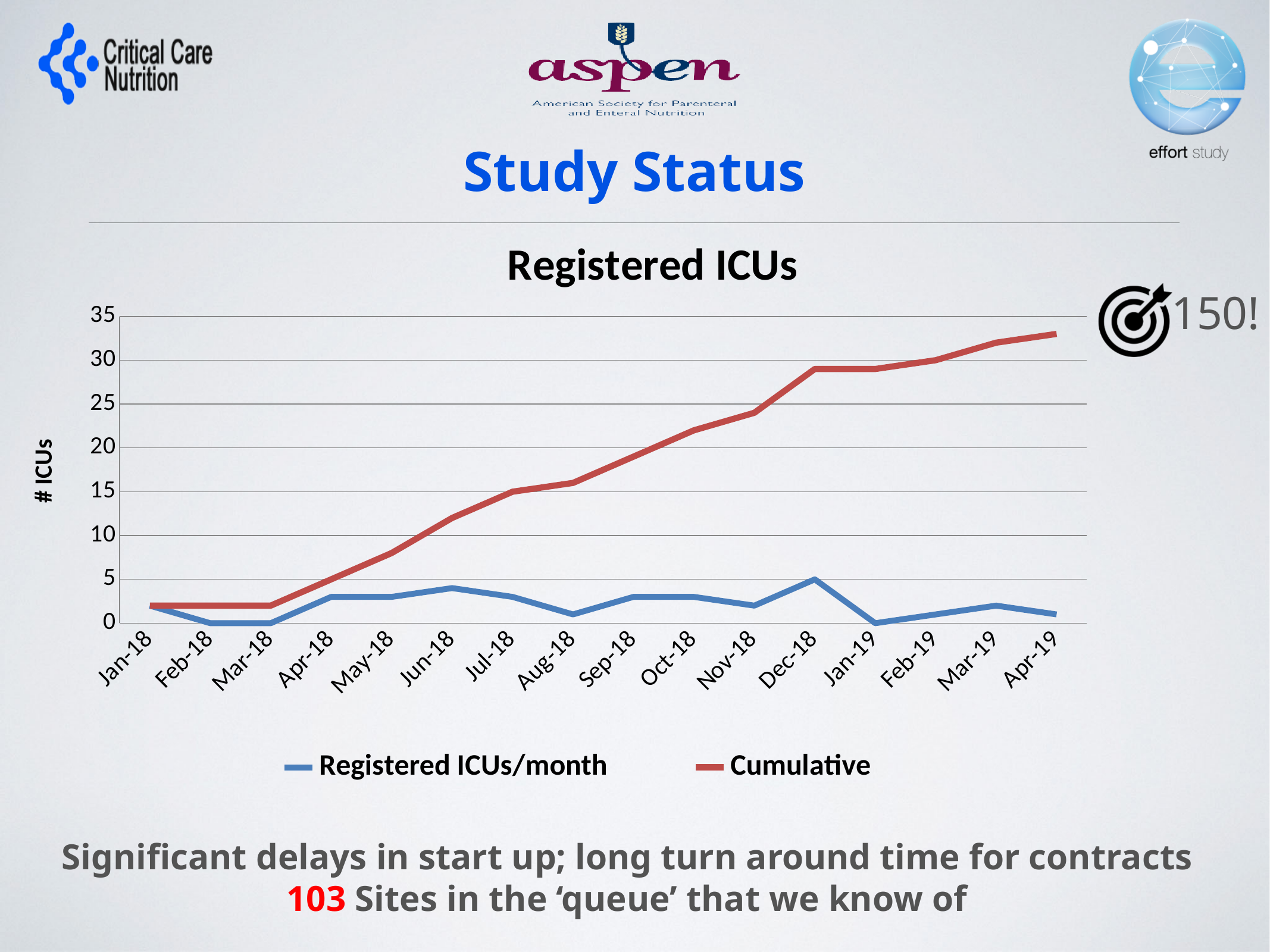
Is the Cumulative value for Jan-18 greater or less than 5? less What colour is the Cumulative line? red What is the title of the chart? Registered ICUs In which month does the Registered ICUs/month series reach its highest value? Dec-18 How many series does the legend list? 2 Is the Cumulative value for Apr-19 greater or less than 30? greater What kind of chart is shown on the slide? line chart What is the Cumulative value in Jul-18? 15 Does the Cumulative series rise or fall from Jan-18 to Apr-19? rise What is the value of Registered ICUs/month in Dec-18? 5 What is the value of Registered ICUs/month in Feb-18? 0 How many months are plotted along the x axis? 16